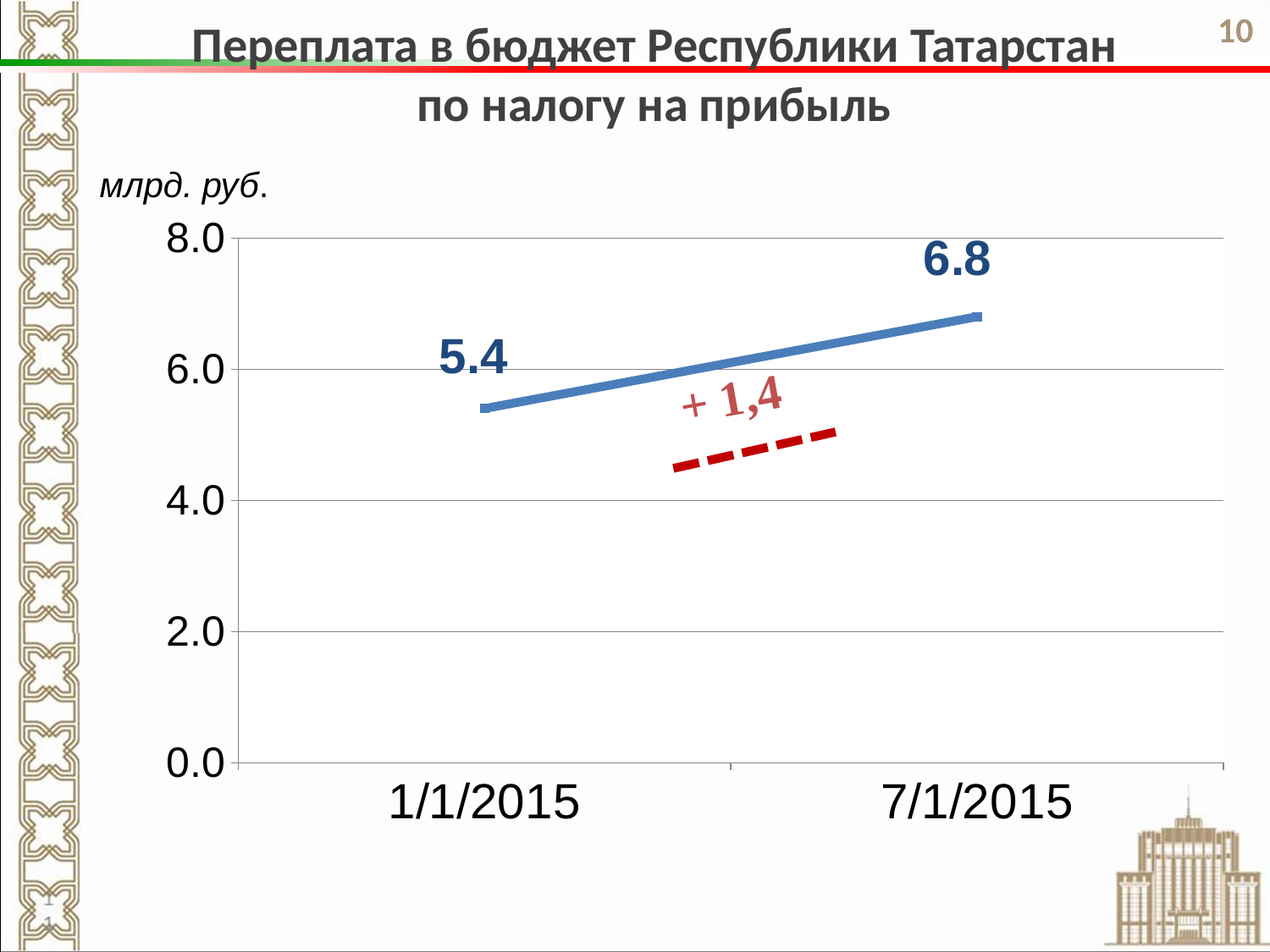
Is the value for 7/1/2015 greater or less than 6.0? greater What kind of chart is shown on the slide? line chart Is the value for 7/1/2015 larger or smaller than the value for 1/1/2015? larger What is the difference between the values for 7/1/2015 and 1/1/2015? 1.4 What is the value for 7/1/2015? 6.8 Do the values rise or fall from 1/1/2015 to 7/1/2015? rise How many data points are plotted on the chart? 2 Is the value for 1/1/2015 greater or less than 6.0? less What is the value for 1/1/2015? 5.4 Which date has the higher value? 7/1/2015 Which date has the lower value? 1/1/2015 What unit is indicated above the chart's vertical axis? млрд. руб.